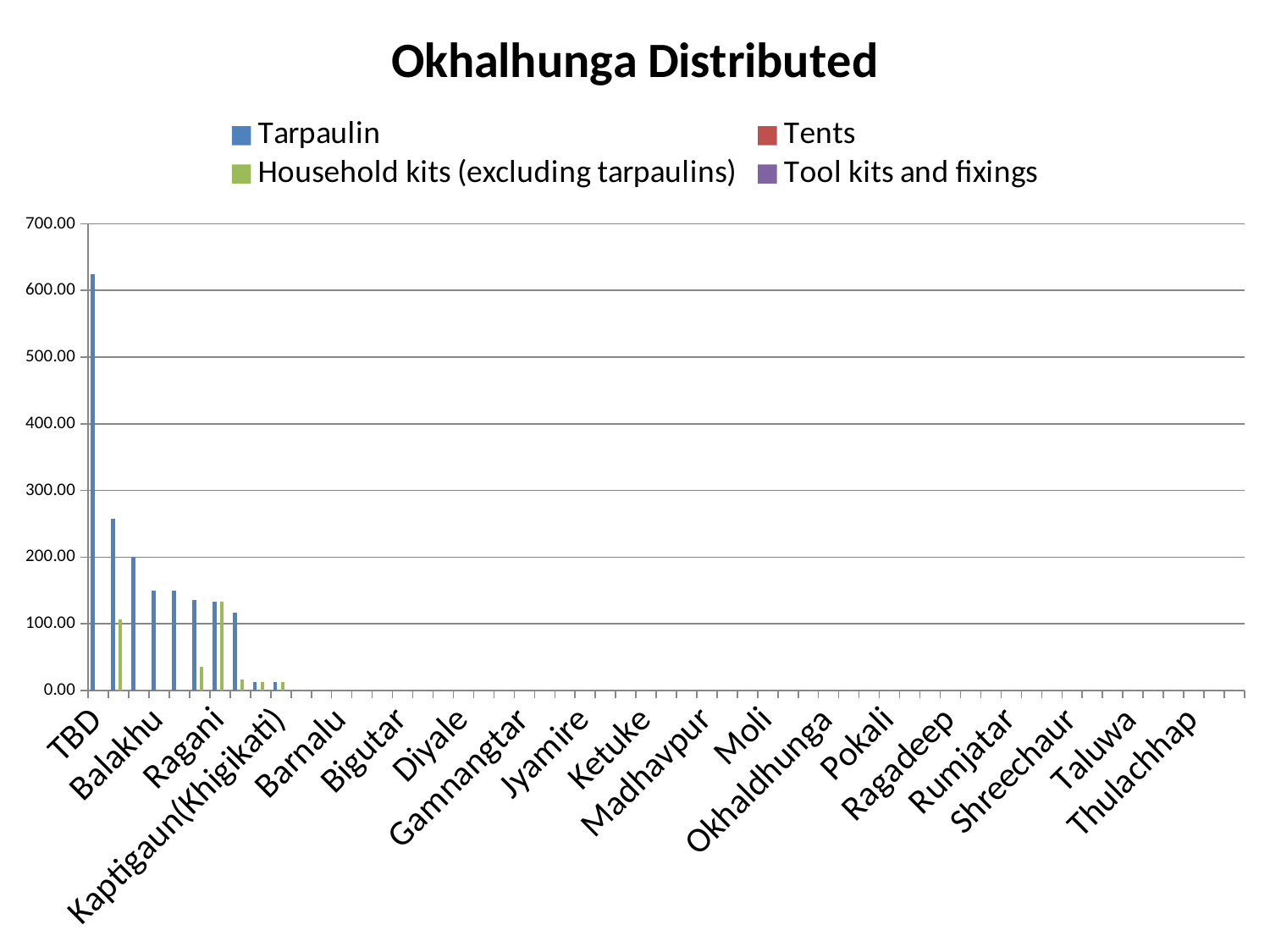
Which series has the tallest bar on the chart? Tarpaulin Which category has the highest Tarpaulin value? TBD What is the title of the chart? Okhalhunga Distributed Is the Tarpaulin value for Balakhu greater or less than 400? less What kind of chart is shown on the slide? bar chart How many series does the legend list? 4 Do the Tarpaulin values generally rise or fall moving from left to right along the x axis? fall Is the Tarpaulin value for TBD greater or less than 700? less Is the Tarpaulin value for TBD greater or less than 600? greater Which series is shown in blue in the legend? Tarpaulin Which is larger, the Tarpaulin value for TBD or the Tarpaulin value for Balakhu? TBD